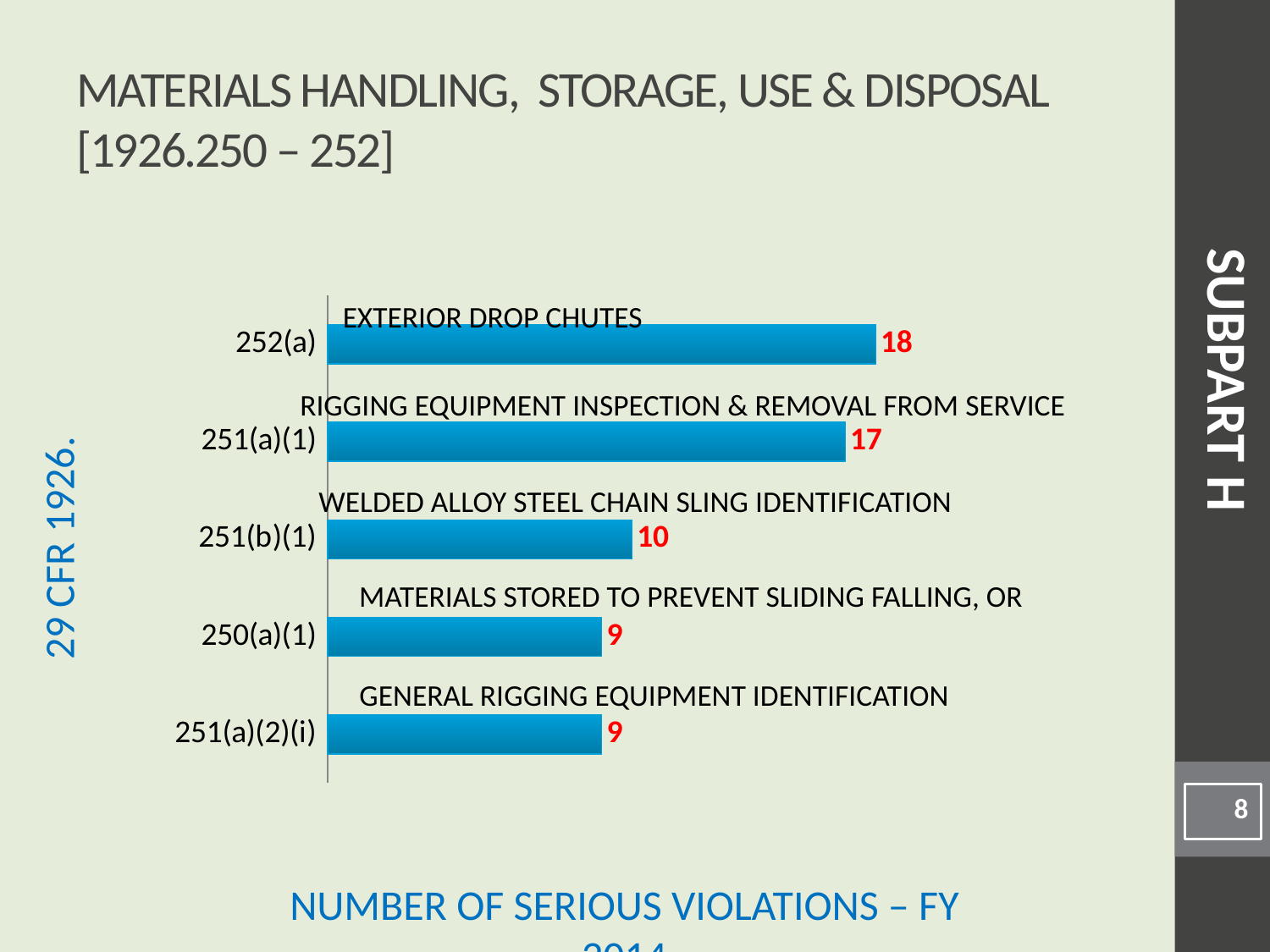
What kind of chart is shown on the slide? Bar chart Which has a larger value, 251(a)(1) or 251(b)(1)? 251(a)(1) What is the description label shown above the bar for 252(a)? EXTERIOR DROP CHUTES What is the number of serious violations for 250(a)(1)? 9 What is the total of the values for 250(a)(1) and 251(a)(2)(i)? 18 How many categories are shown in the chart? 5 What is the number of serious violations for 251(a)(1)? 17 Which category has the highest number of serious violations? 252(a) What is the difference between the values for 251(a)(1) and 250(a)(1)? 8 What is the difference between the values for 252(a) and 251(b)(1)? 8 What is the number of serious violations for 251(b)(1)? 10 What is the number of serious violations for 252(a)? 18